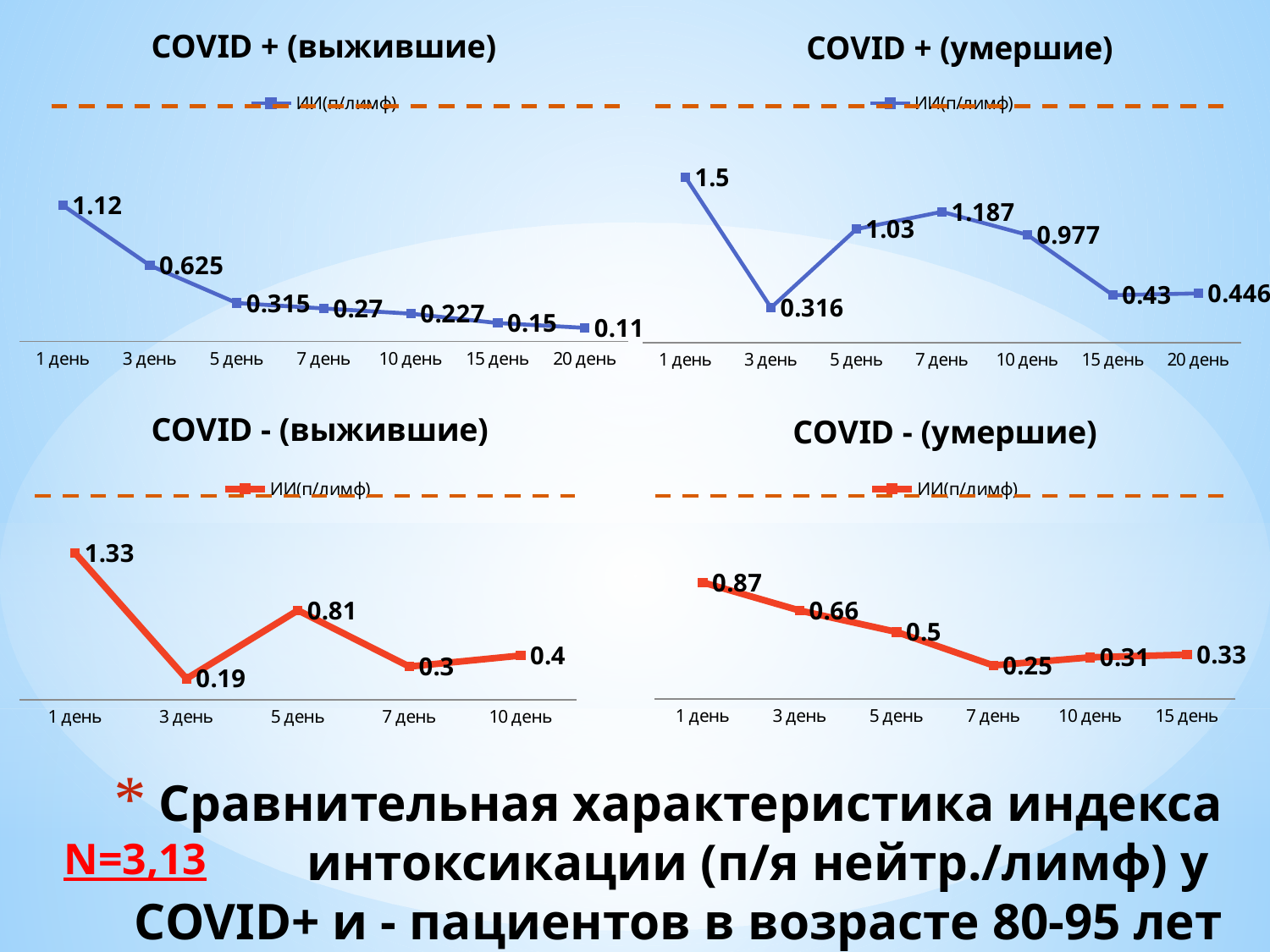
In the 'COVID - (выжившие)' chart, which is larger: the value on 5 день or the value on 7 день? 5 день In the 'COVID + (выжившие)' chart, what is the value on 20 день? 0.11 In the 'COVID + (умершие)' chart, which day has the lowest value? 3 день In the 'COVID - (выжившие)' chart, how many data points are plotted? 5 In the 'COVID - (умершие)' chart, which day has the highest value? 1 день In the 'COVID - (умершие)' chart, what is the value on 15 день? 0.33 In the 'COVID - (умершие)' chart, what is the difference between the values on 1 день and 7 день? 0.62 What type of chart is the 'COVID + (выжившие)' chart? Line chart In the 'COVID + (умершие)' chart, what is the difference between the values on 1 день and 3 день? 1.184 In the 'COVID + (выжившие)' chart, what is the value on 1 день? 1.12 In the 'COVID + (выжившие)' chart, do the values rise or fall from 1 день to 20 день? Fall In the 'COVID + (умершие)' chart, what is the value on 7 день? 1.187